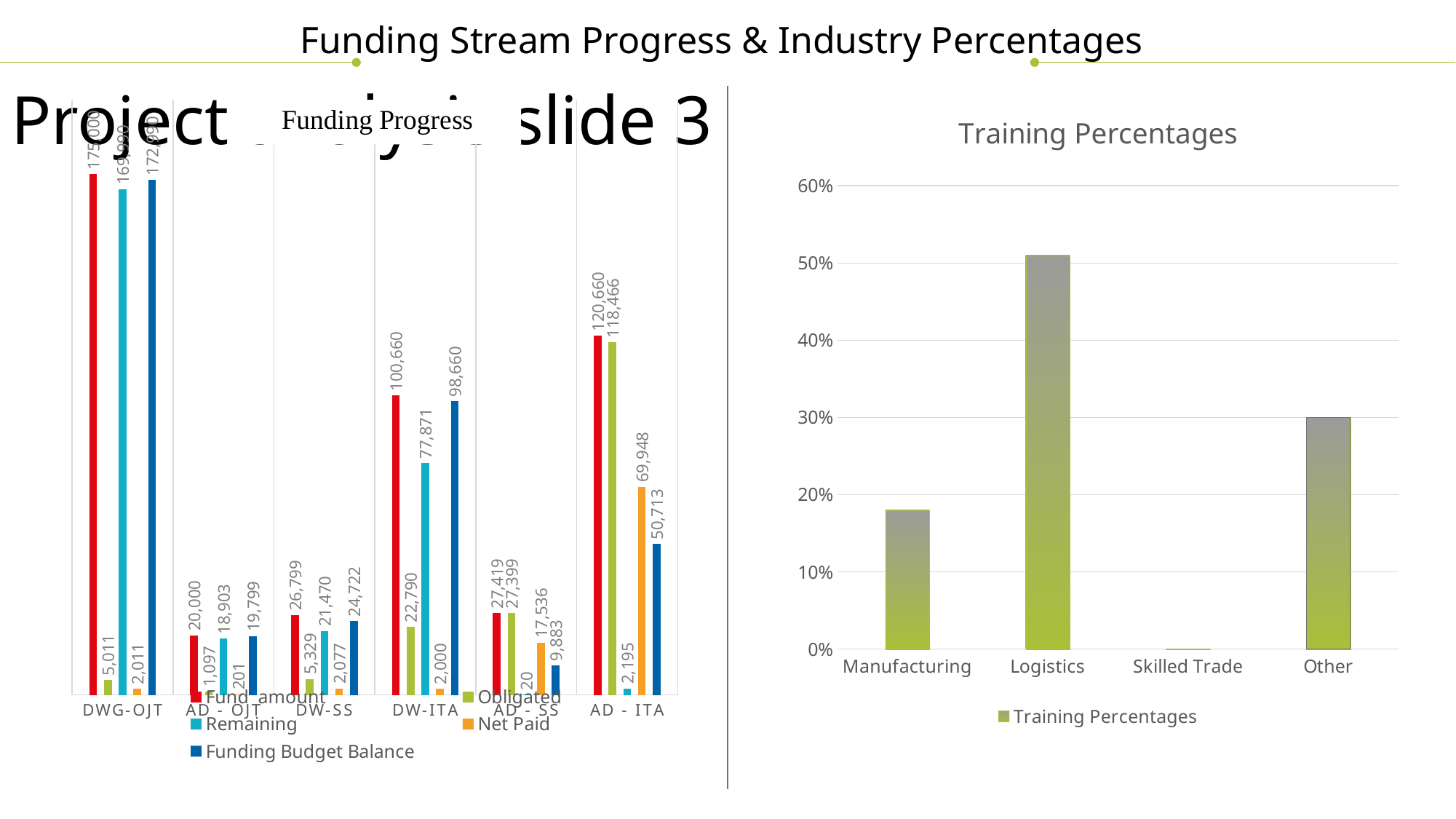
In the Funding Progress chart, what is the Net Paid value for AD - ITA? 69,948 In the Training Percentages chart, is the value for Manufacturing greater or less than 20%? less In the Funding Progress chart, how many funding stream categories are shown on the x axis? 6 In the Training Percentages chart, which industry has the highest percentage? Logistics What kind of chart is the Training Percentages chart? bar chart In the Funding Progress chart, how many series does the legend list? 5 In the Funding Progress chart, what is the difference between the Fund amount and the Funding Budget Balance for DW-ITA? 2,000 In the Training Percentages chart, is the value for Other greater or less than 20%? greater In the Training Percentages chart, which industry has the lowest percentage? Skilled Trade In the Funding Progress chart, which has the larger Funding Budget Balance, DW-ITA or AD - ITA? DW-ITA In the Funding Progress chart, what is the Fund amount for DW-ITA? 100,660 In the Training Percentages chart, how many industry categories are shown? 4